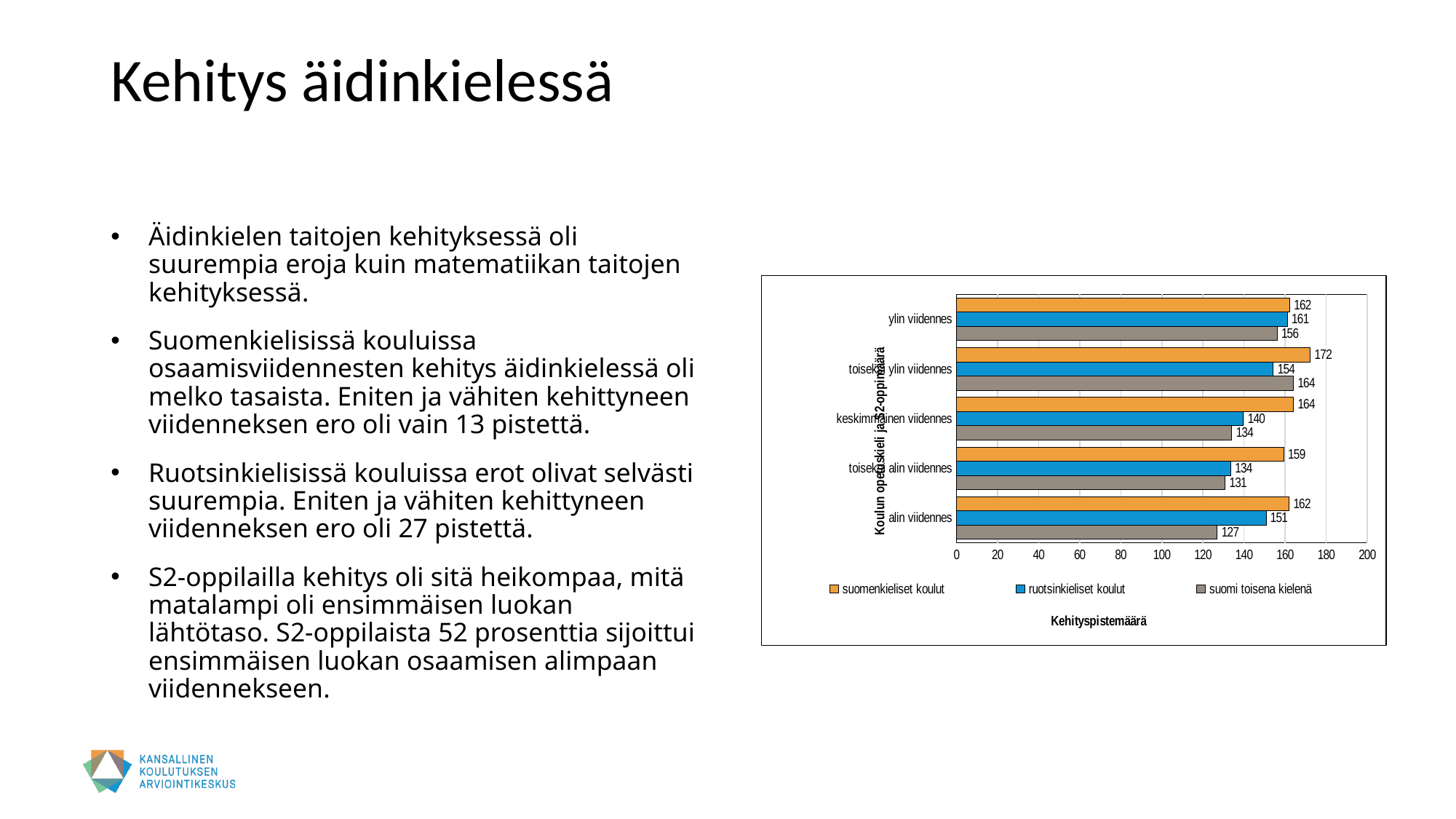
In the toiseksi ylin viidennes category, which is larger: ruotsinkieliset koulut or suomi toisena kielenä? suomi toisena kielenä Which category has the lowest value for suomi toisena kielenä? alin viidennes What is the difference between the suomenkieliset koulut and ruotsinkieliset koulut values in the keskimmäinen viidennes category? 24 How many series does the legend list? 3 What is the value for ruotsinkieliset koulut in the keskimmäinen viidennes category? 140 What type of chart is shown on the slide? bar chart Which category has the highest value for suomenkieliset koulut? toiseksi ylin viidennes What is the title of the x axis of the chart? Kehityspistemäärä How many categories (viidennes groups) are shown on the y axis? 5 Is the value for ruotsinkieliset koulut in the alin viidennes category greater or less than 140? greater What is the value for suomi toisena kielenä in the alin viidennes category? 127 What is the value for suomenkieliset koulut in the toiseksi ylin viidennes category? 172